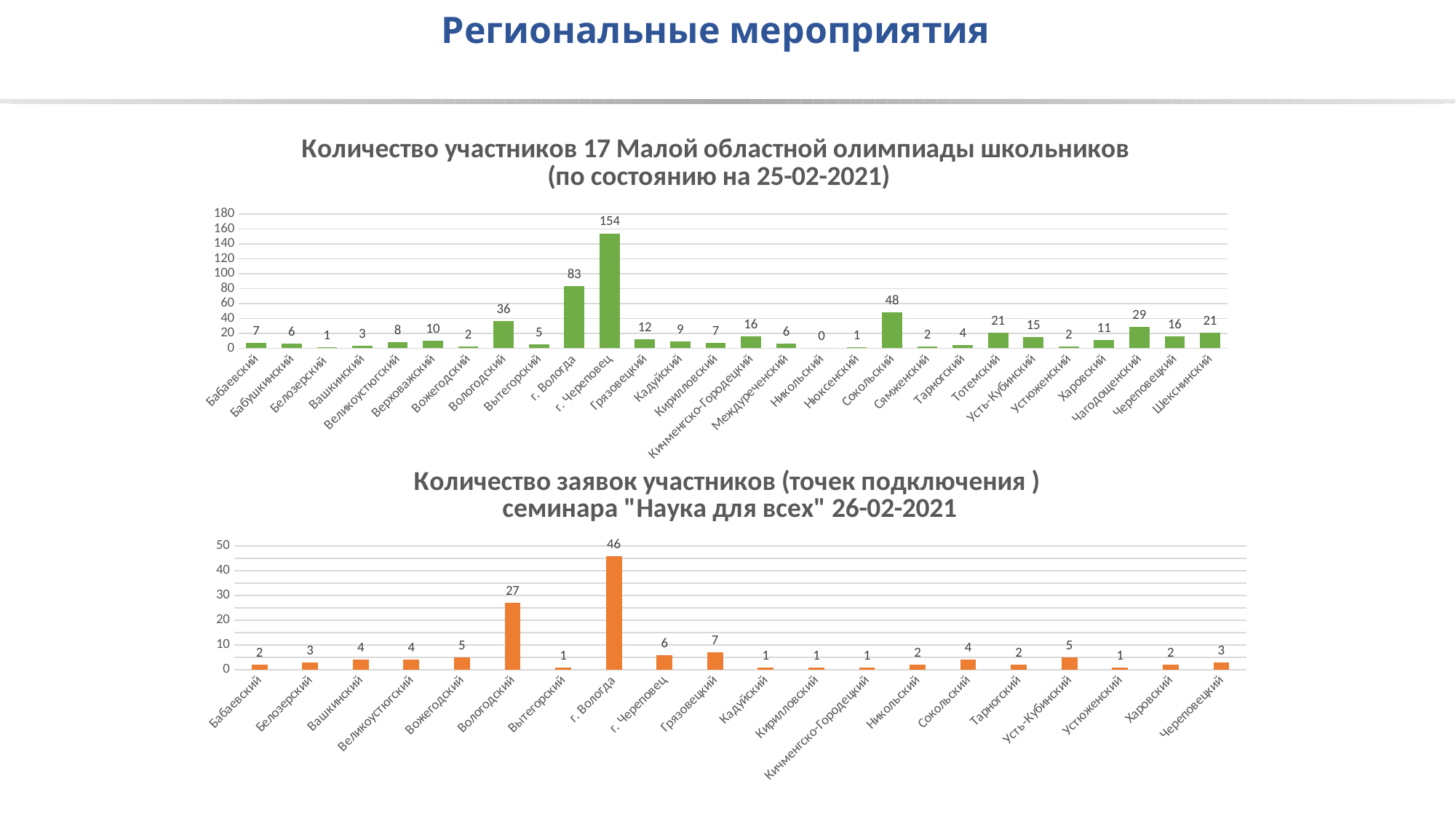
In the bottom chart (Количество заявок участников семинара "Наука для всех"), how many categories are shown on the x axis? 20 In the bottom chart (Количество заявок участников семинара "Наука для всех"), what is the value for Вологодский? 27 In the top chart (Количество участников 17 Малой областной олимпиады школьников), what is the value for г. Череповец? 154 In the top chart (Количество участников 17 Малой областной олимпиады школьников), which category has the lowest value? Никольский In the bottom chart (Количество заявок участников семинара "Наука для всех"), which category has the highest value? г. Вологда What colour are the bars in the top chart (Количество участников 17 Малой областной олимпиады школьников)? Green What type of chart is the bottom chart (Количество заявок участников семинара "Наука для всех")? Bar chart In the top chart (Количество участников 17 Малой областной олимпиады школьников), what is the value for Сокольский? 48 In the top chart (Количество участников 17 Малой областной олимпиады школьников), what is the difference between г. Череповец and г. Вологда? 71 In the top chart (Количество участников 17 Малой областной олимпиады школьников), which is larger: Чагодощенский or Тотемский? Чагодощенский In the top chart (Количество участников 17 Малой областной олимпиады школьников), how many categories are shown on the x axis? 28 In the bottom chart (Количество заявок участников семинара "Наука для всех"), what is the difference between г. Вологда and Вологодский? 19